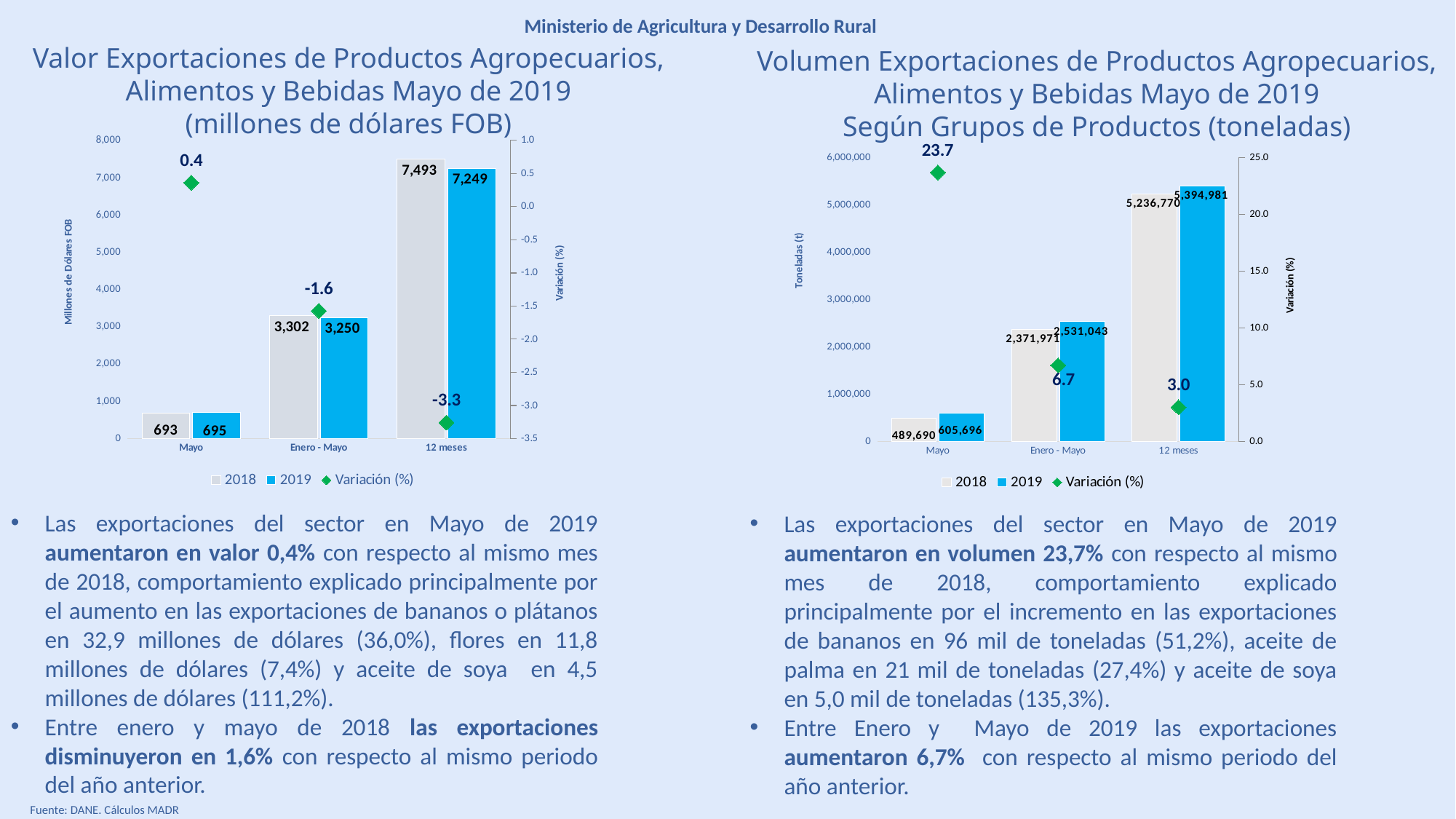
In the right chart (Volumen Exportaciones), what is the 2019 value for Mayo? 605,696 In the left chart (Valor Exportaciones), which category has the lowest Variación (%)? 12 meses In the left chart (Valor Exportaciones), what is the 2018 value for Mayo? 693 In the right chart (Volumen Exportaciones), what is the 2018 value for Enero - Mayo? 2,371,971 In the left chart (Valor Exportaciones), what is the Variación (%) for Enero - Mayo? -1.6 In the right chart (Volumen Exportaciones), which category has the highest Variación (%)? Mayo In the left chart (Valor Exportaciones), how many series does the legend list? 3 In the left chart (Valor Exportaciones), what is the difference between the 2018 and 2019 values for 12 meses? 244 In the right chart (Volumen Exportaciones), which is larger for 12 meses, the 2018 value or the 2019 value? 2019 What type of chart is the left chart (Valor Exportaciones)? Bar chart with a line/marker series In the right chart (Volumen Exportaciones), how many categories are shown on the x axis? 3 In the left chart (Valor Exportaciones), what is the 2019 value for 12 meses? 7,249